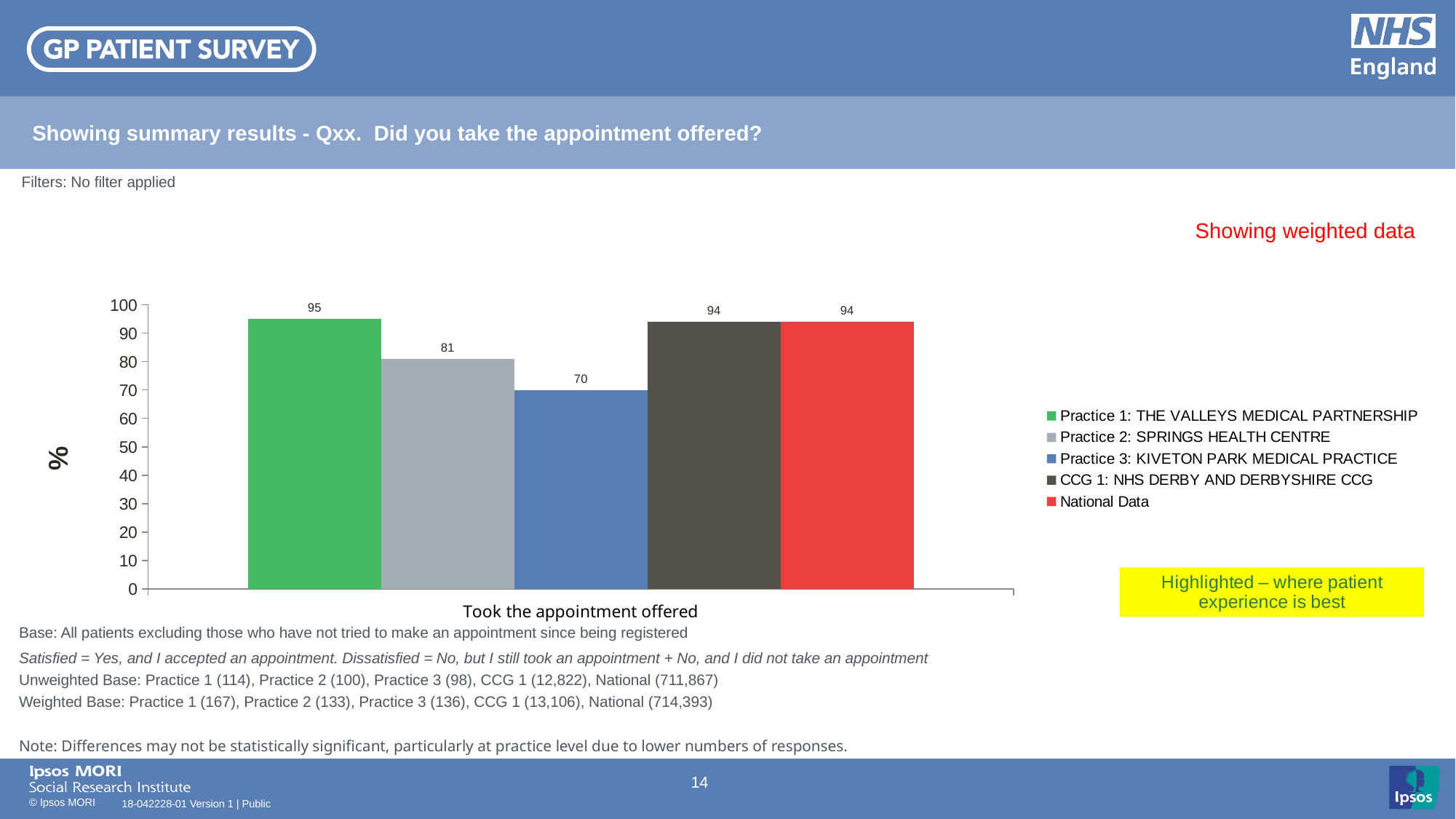
Which series has the highest value? Practice 1: THE VALLEYS MEDICAL PARTNERSHIP Which is larger, the value for Practice 2: SPRINGS HEALTH CENTRE or the value for National Data? National Data What is the label on the y axis of the chart? % What is the value for CCG 1: NHS DERBY AND DERBYSHIRE CCG? 94 What is the value for Practice 3: KIVETON PARK MEDICAL PRACTICE? 70 How many series does the legend list? 5 What kind of chart is shown on the slide? Bar chart What is the value for National Data? 94 What is the value for Practice 2: SPRINGS HEALTH CENTRE? 81 What is the value for Practice 1: THE VALLEYS MEDICAL PARTNERSHIP for 'Took the appointment offered'? 95 What is the difference between the values for Practice 1 and Practice 3? 25 Which series has the lowest value? Practice 3: KIVETON PARK MEDICAL PRACTICE